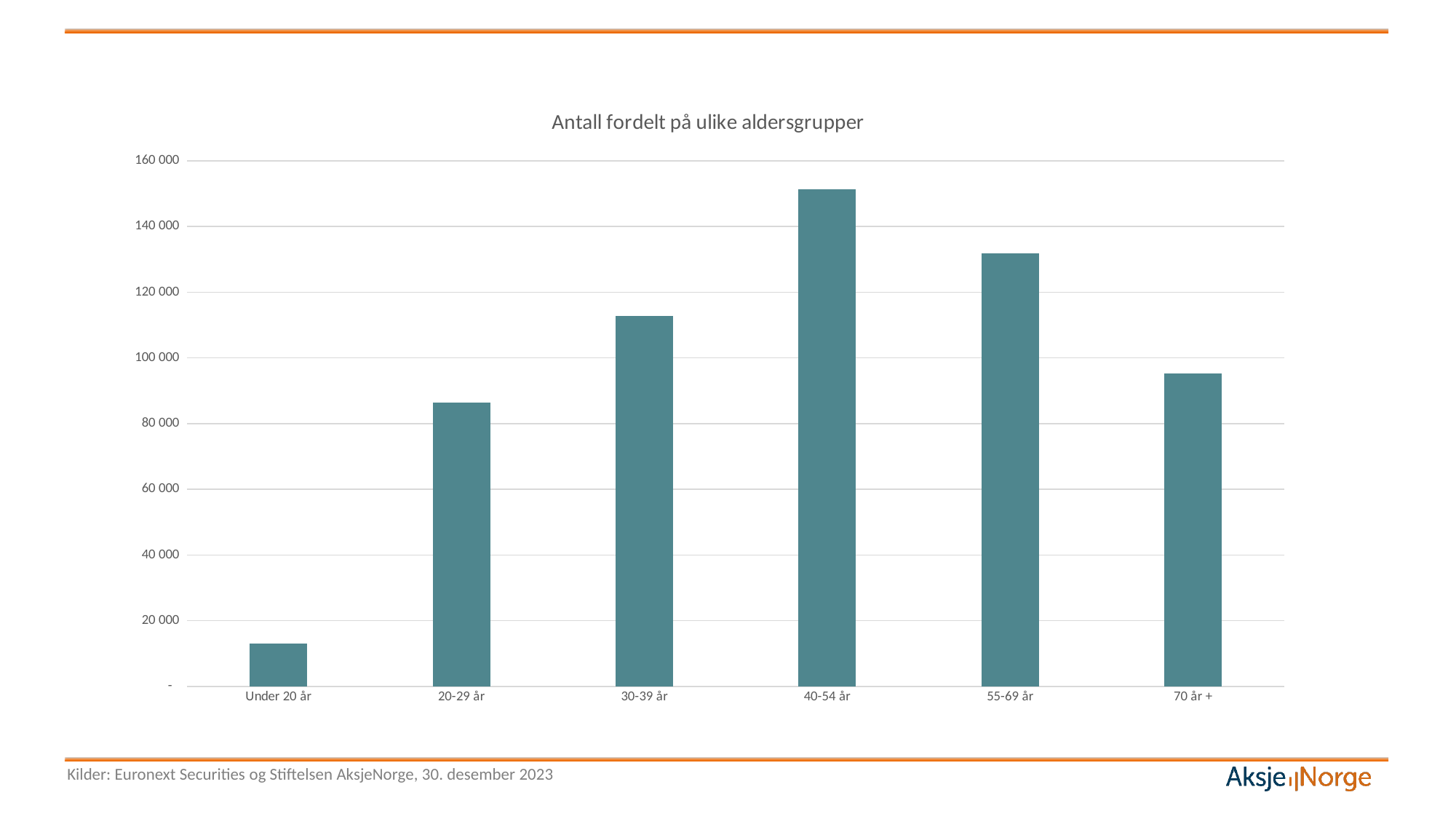
Do the values rise or fall from Under 20 år to 40-54 år? rise What kind of chart is shown on the slide? bar chart Is the value for 70 år + greater or less than 100 000? less Is the value for 40-54 år greater or less than 140 000? greater Is the value for 20-29 år greater or less than 80 000? greater Which age group has the highest value? 40-54 år What is the title of the chart? Antall fordelt på ulike aldersgrupper Which age group has the lowest value? Under 20 år Which is larger, the value for 30-39 år or the value for 70 år +? 30-39 år How many age groups are shown on the x axis? 6